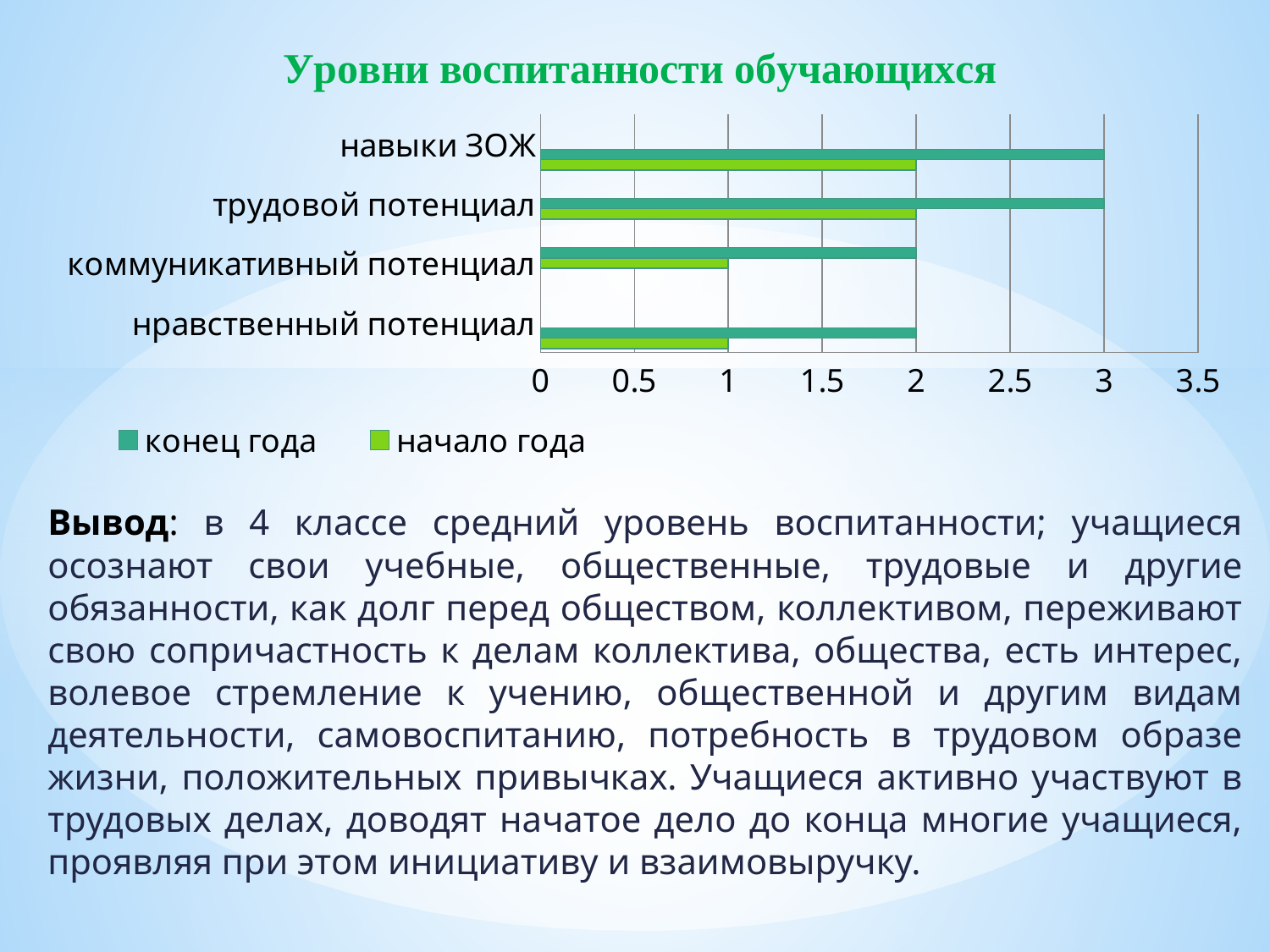
What is the difference between 'конец года' and 'начало года' for 'навыки ЗОЖ'? 1 What is the title of the chart? Уровни воспитанности обучающихся How many categories are shown on the chart? 4 What is the value of 'начало года' for 'трудовой потенциал'? 2 Which is larger for 'коммуникативный потенциал': 'конец года' or 'начало года'? конец года What is the value of 'начало года' for 'коммуникативный потенциал'? 1 What is the value of 'конец года' for 'навыки ЗОЖ'? 3 What is the value of 'конец года' for 'нравственный потенциал'? 2 What kind of chart is shown on the slide? bar chart Is the 'конец года' value for 'трудовой потенциал' greater or less than 2.5? greater How many series does the legend list? 2 Which category has the lowest 'начало года' value, 'трудовой потенциал' or 'нравственный потенциал'? нравственный потенциал